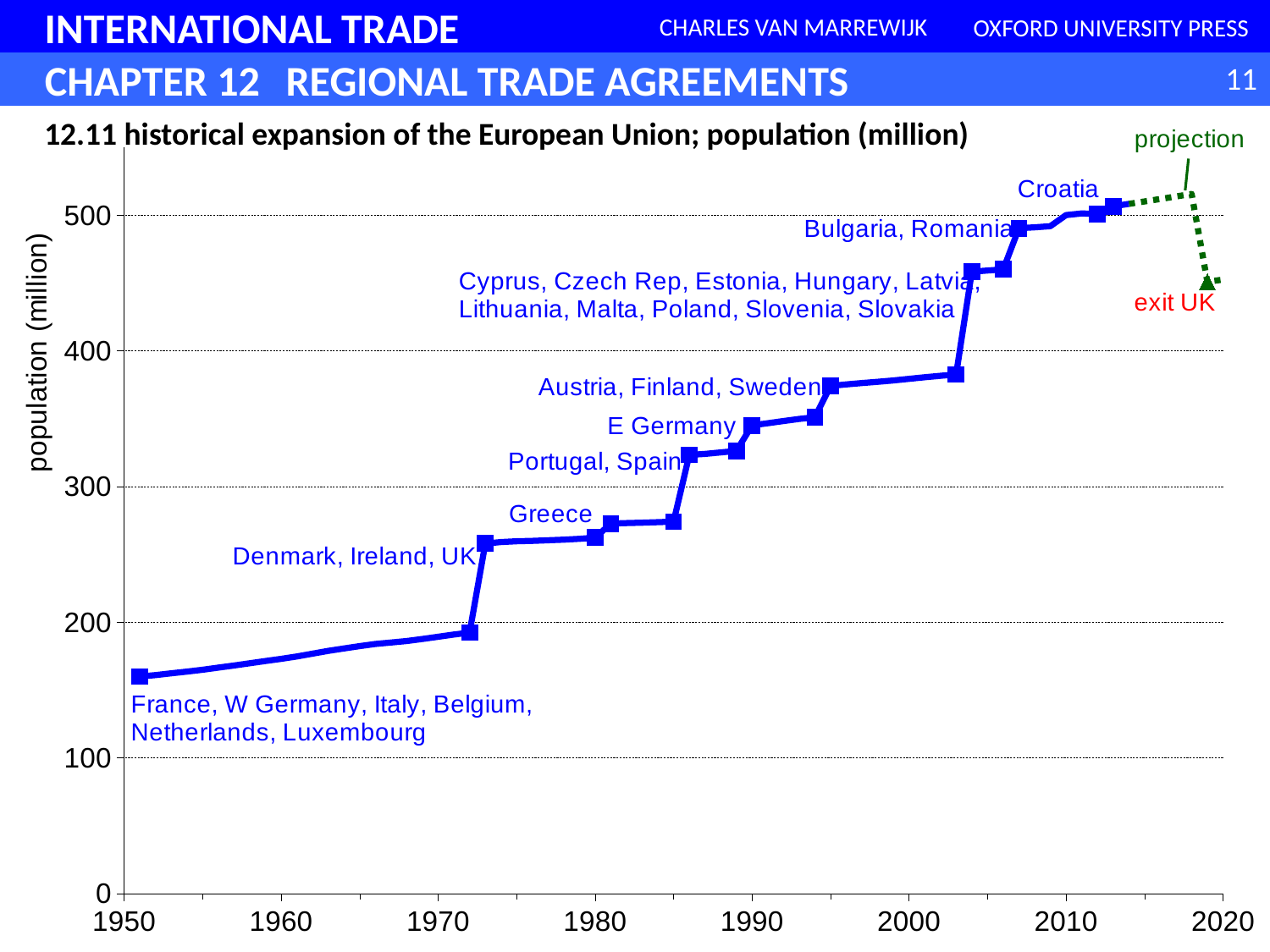
Which country's accession is labelled at the last solid-line step, around 2013? Croatia Is the EU population value just before the 2004 enlargement (around 2003) greater or less than 400? less Is the projected EU population value at the end of the green dotted line (after 'exit UK') greater or less than 500? less Does the solid blue line for EU population generally rise or fall from 1950 to 2013? rise Is the EU population value at the first data point (around 1951) greater or less than 200? less What is the label on the vertical axis of the chart? population (million) What is the title of the chart? 12.11 historical expansion of the European Union; population (million) What kind of chart is shown on the slide? line chart